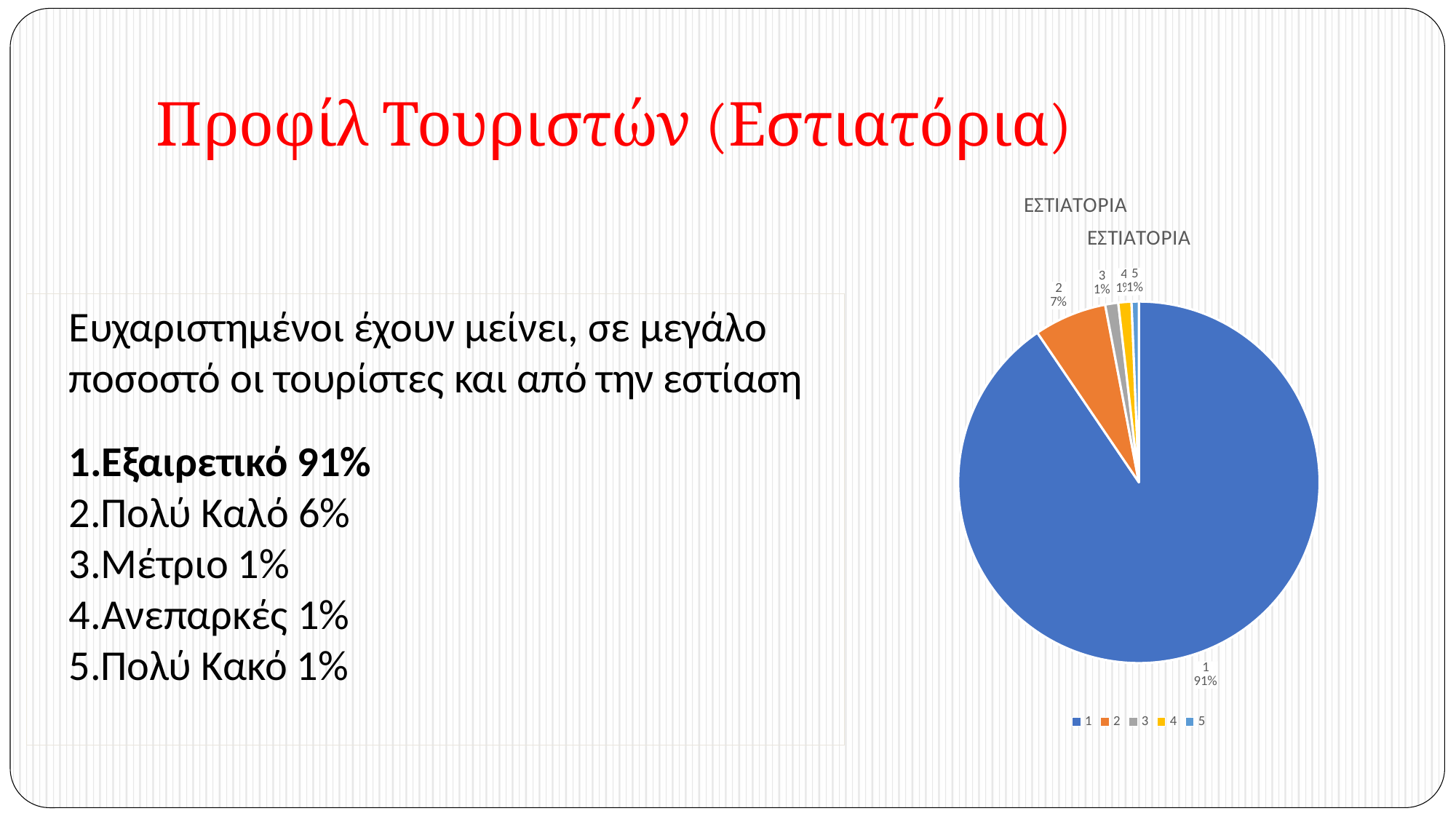
What is the difference between the share of category 1 and the share of category 2? 84% Which category has the largest slice of the pie? 1 What kind of chart is shown on the slide? pie chart Which is larger, the slice for category 2 or the slice for category 3? 2 What share of the pie does category 1 have? 91% How many slices does the pie chart have? 5 What colour is the slice for category 2? orange What is the title of the pie chart? ΕΣΤΙΑΤΟΡΙΑ What share of the pie does category 2 have? 7% How many entries does the legend list? 5 What share of the pie does category 3 have? 1% Which is larger, the slice for category 1 or the slice for category 2? 1